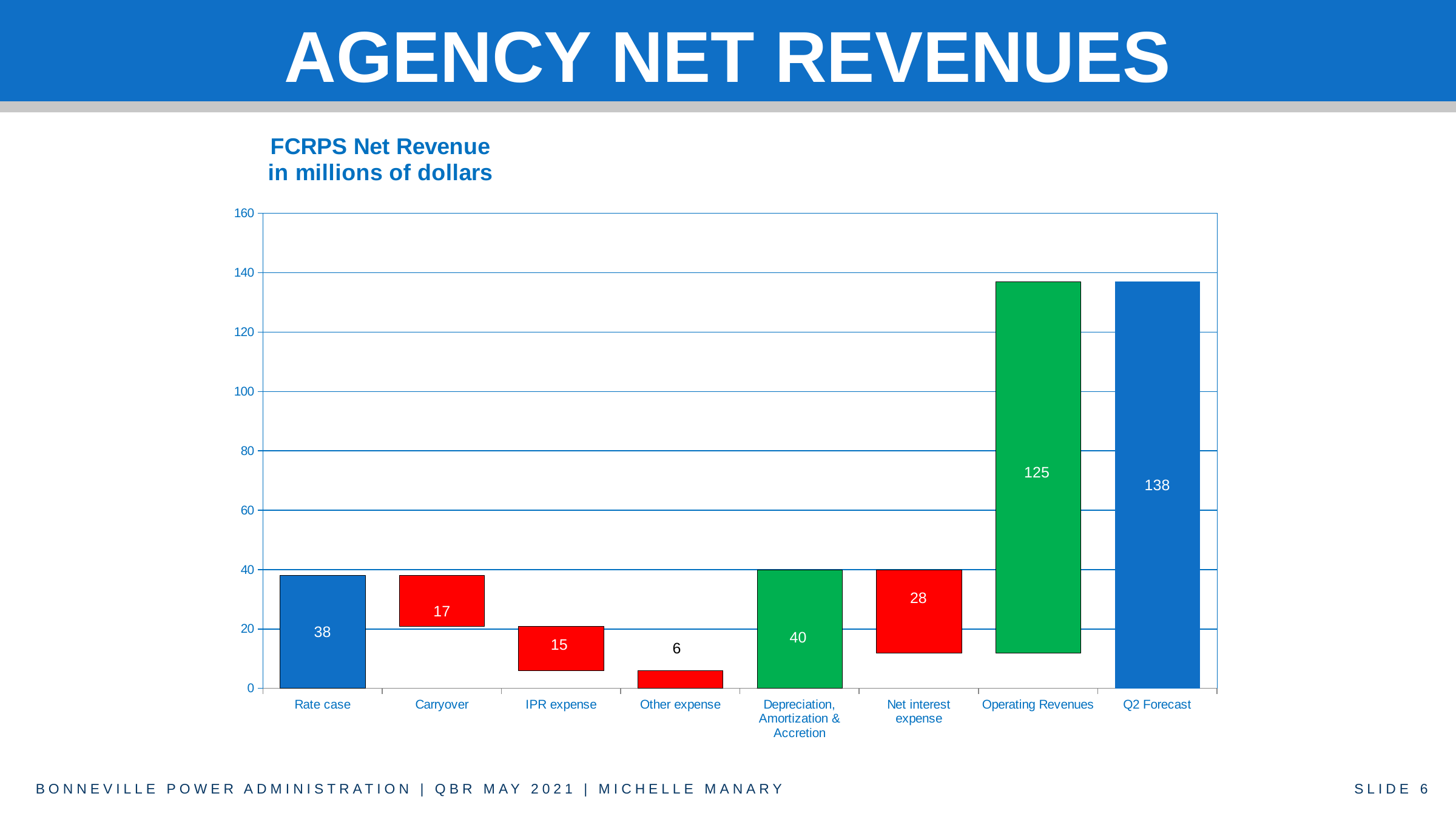
What kind of chart is shown on the slide? bar chart Which is larger, the value for Depreciation, Amortization & Accretion or the value for Net interest expense? Depreciation, Amortization & Accretion What is the difference between the Carryover value and the IPR expense value? 2 What unit does the chart title say the values are in? millions of dollars Which category has the largest labelled value? Q2 Forecast Which category has the smallest labelled value? Other expense What value is shown for Operating Revenues? 125 What value is labelled on the Net interest expense bar? 28 What is the value for Q2 Forecast? 138 What is the value labelled on the Rate case bar? 38 What is the difference between the Q2 Forecast value and the Operating Revenues value? 13 How many categories are shown on the x axis? 8